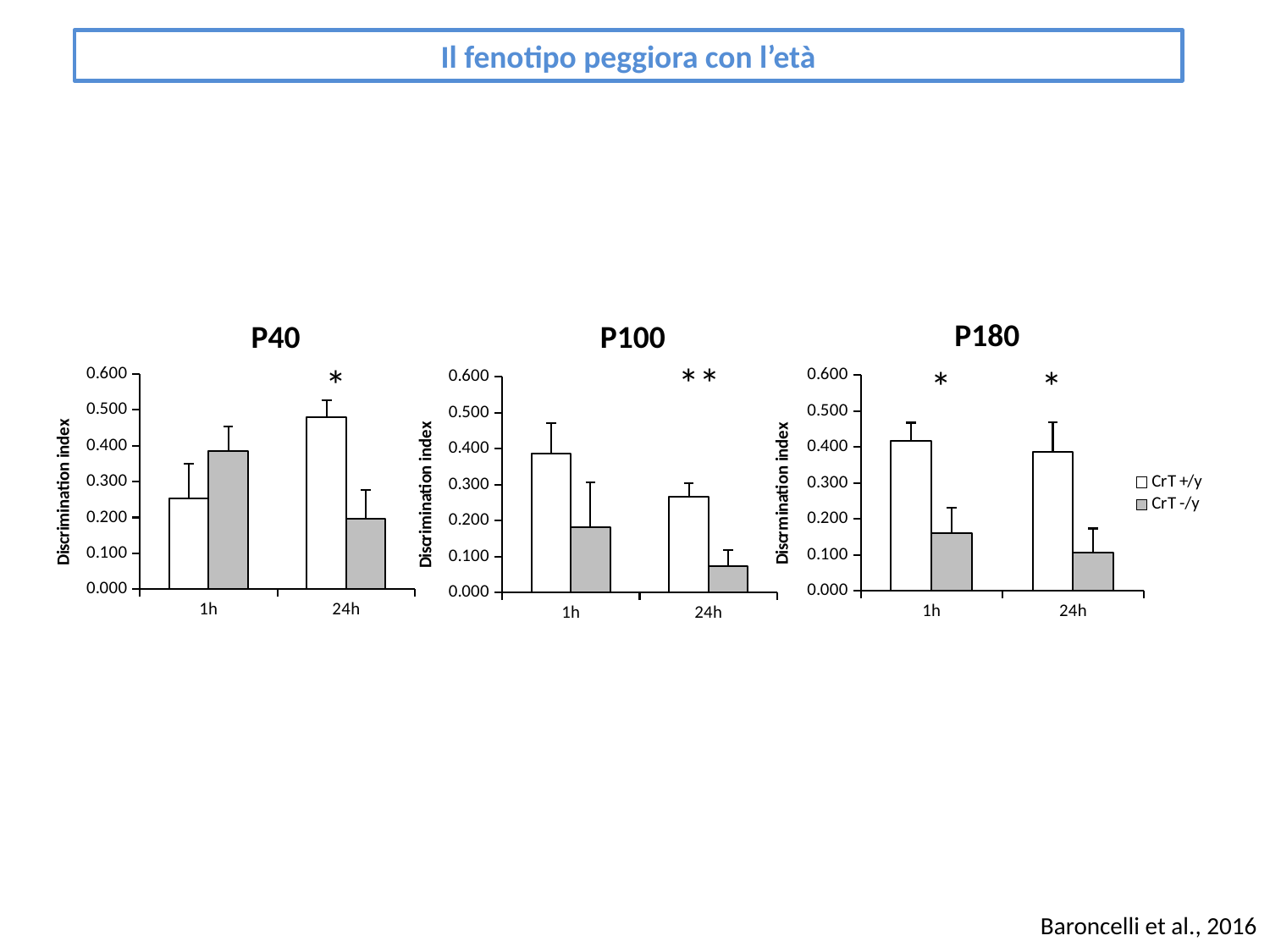
In the P180 chart, which bar is the highest? CrT +/y at 1h In the P180 chart, is the CrT -/y value at 1h greater or less than 0.200? less In the P40 chart, is the CrT +/y value at 24h greater or less than 0.400? greater What kind of chart is the P40 chart? bar chart In the P40 chart, which series has the larger value at 24h, CrT +/y or CrT -/y? CrT +/y In the P40 chart, which series has the larger value at 1h, CrT +/y or CrT -/y? CrT -/y In the P100 chart, is the CrT -/y value at 24h greater or less than 0.100? less What is the y-axis label on the P100 chart? Discrimination index How many series does the legend list for the charts? 2 How many categories are shown on the x axis of the P100 chart? 2 In the P180 chart, which bar is the lowest? CrT -/y at 24h